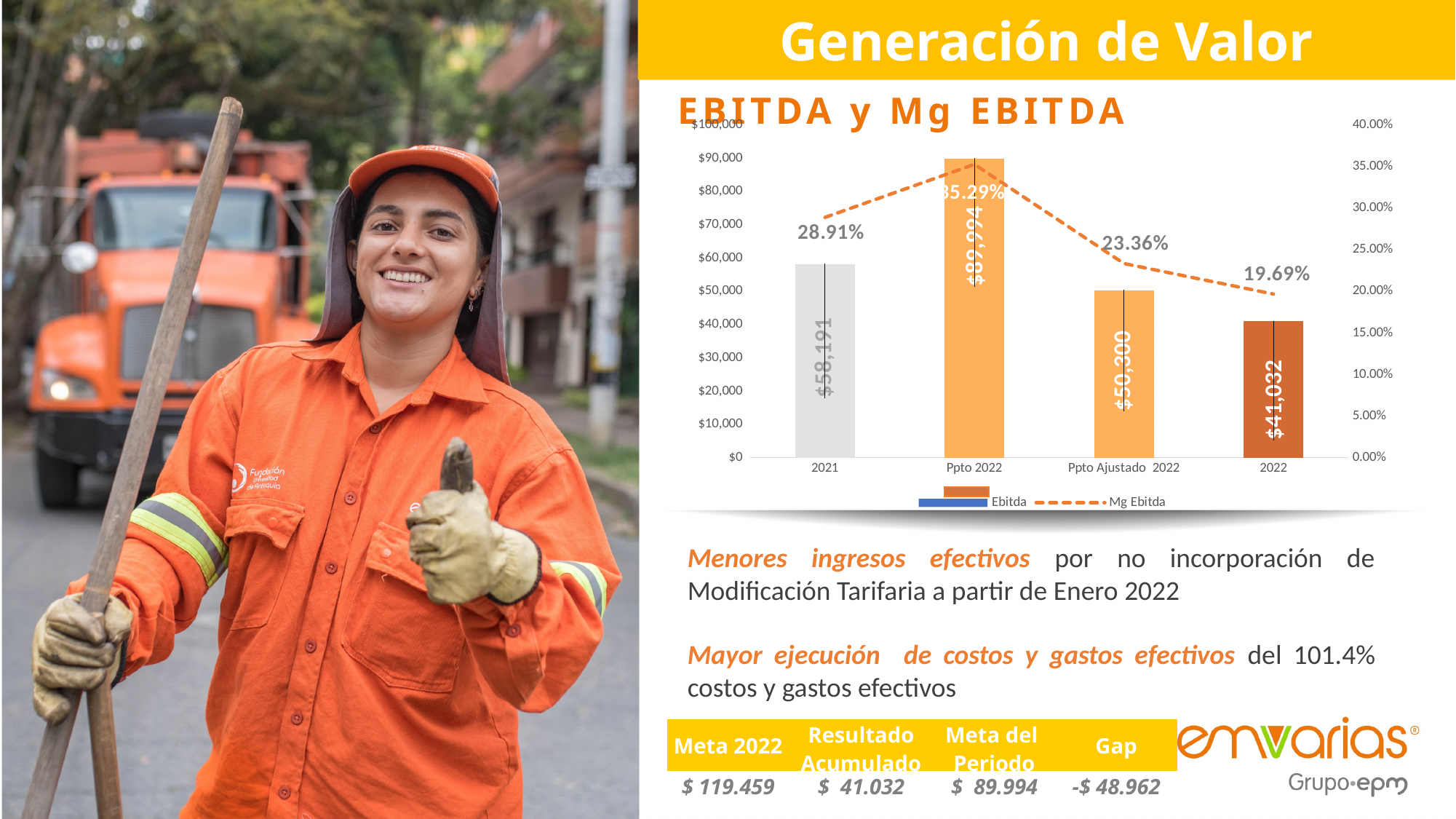
What is the Mg Ebitda value for 2022? 19.69% What is the title of the chart? EBITDA y Mg EBITDA Which category has the lowest Mg Ebitda? 2022 What is the Ebitda value for 2021? $58,191 What is the Mg Ebitda value for Ppto Ajustado 2022? 23.36% How many categories are shown on the x axis of the chart? 4 What is the difference in Ebitda between Ppto 2022 and 2022? $48,962 What is the Ebitda value for Ppto 2022? $89,994 How many series does the chart legend list? 2 Which is larger, the Ebitda for 2021 or for Ppto Ajustado 2022? 2021 What is the Ebitda value for 2022? $41,032 Which category has the highest Ebitda? Ppto 2022